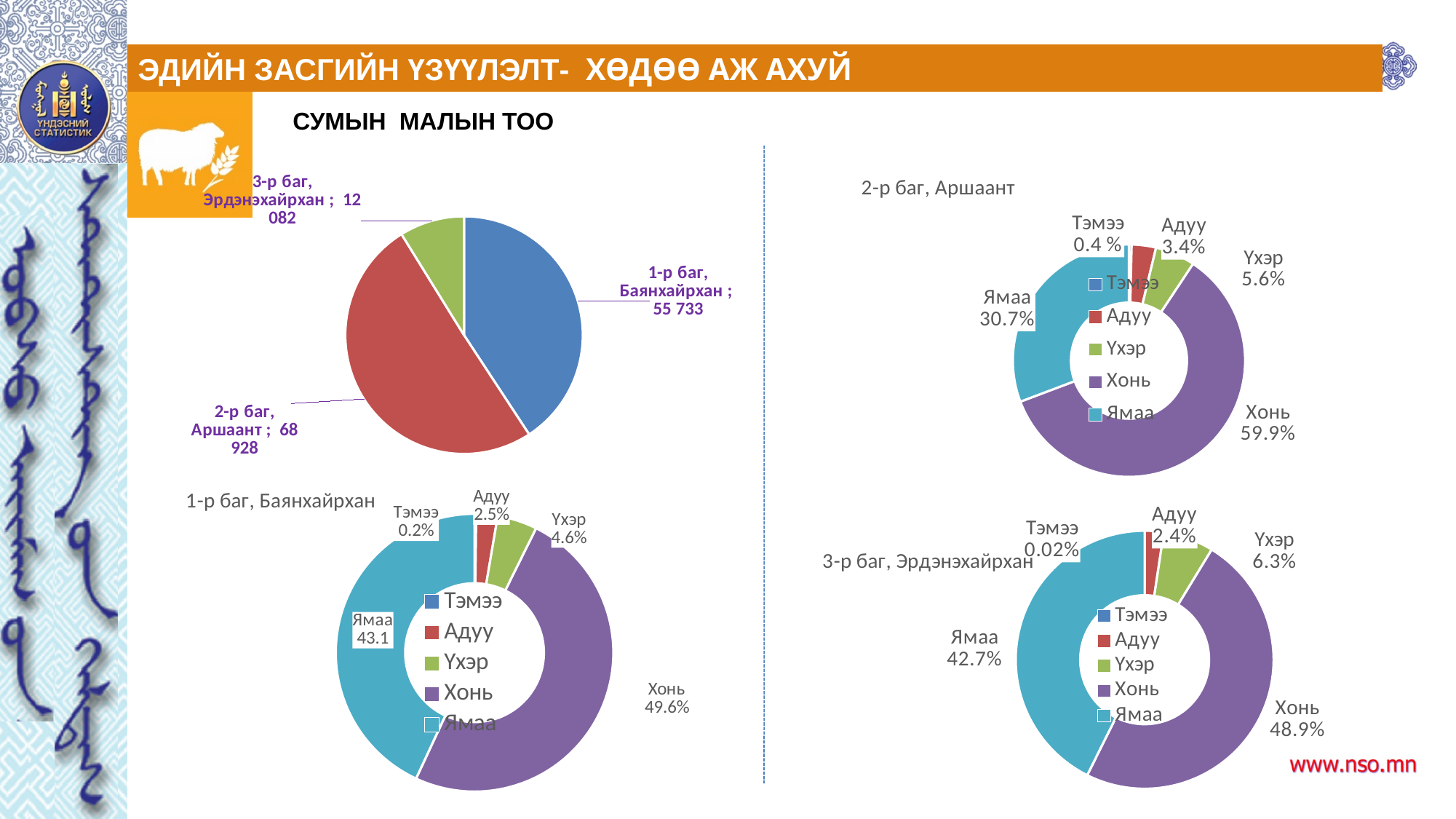
How many categories does the top-left pie chart show? 3 In the doughnut chart titled 1-р баг, Баянхайрхан, what is the share for Үхэр? 4.6% In the doughnut chart titled 2-р баг, Аршаант, which category has the largest share? Хонь In the top-left pie chart, what is the difference between the values for 2-р баг, Аршаант and 1-р баг, Баянхайрхан? 13 195 What kind of chart is the top-left chart showing the three bags? Pie chart In the doughnut chart titled 3-р баг, Эрдэнэхайрхан, what is the difference between the shares for Хонь and Ямаа? 6.2% In the doughnut chart titled 2-р баг, Аршаант, what is the share for Хонь? 59.9% In the top-left pie chart, what is the value for 2-р баг, Аршаант? 68 928 In the doughnut chart titled 3-р баг, Эрдэнэхайрхан, what is the share for Тэмээ? 0.02% In the top-left pie chart, which category has the lowest value? 3-р баг, Эрдэнэхайрхан How many series does the legend of the doughnut chart titled 3-р баг, Эрдэнэхайрхан list? 5 In the doughnut chart titled 1-р баг, Баянхайрхан, which is larger, Хонь or Ямаа? Хонь